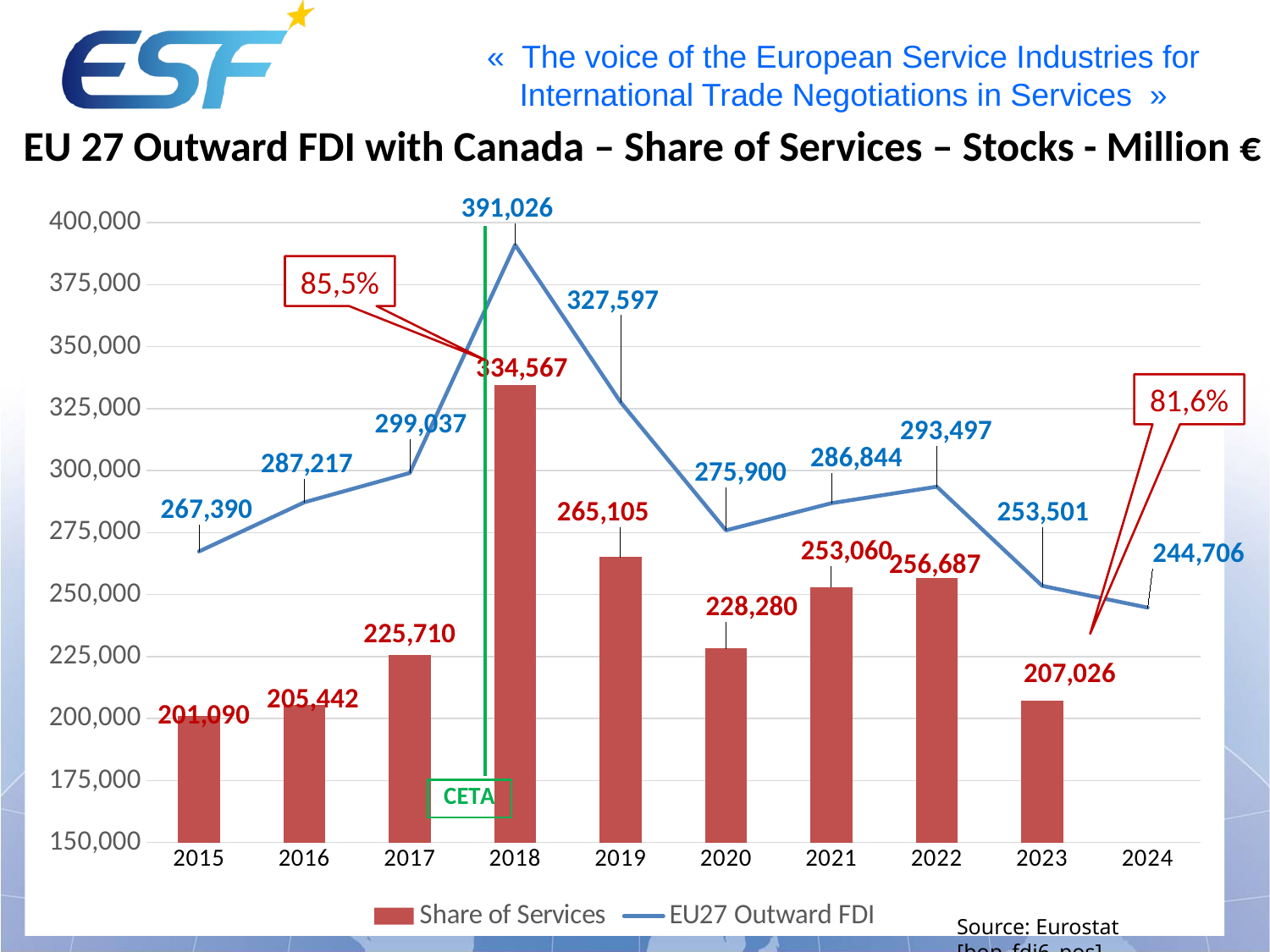
How many years are shown on the x axis? 10 How many series does the legend list? 2 What is the EU27 Outward FDI value for 2024? 244,706 What is the Share of Services value for 2018? 334,567 In which year is the EU27 Outward FDI line at its highest? 2018 In which year is the Share of Services bar the lowest? 2015 What is the difference between EU27 Outward FDI and Share of Services in 2018? 56,459 What kind of chart is this? Combined bar and line chart Which year has the larger Share of Services value, 2021 or 2022? 2022 Does the EU27 Outward FDI line rise or fall from 2022 to 2024? Fall What percentage is shown in the callout pointing to 2018? 85,5% What is the EU27 Outward FDI value for 2020? 275,900